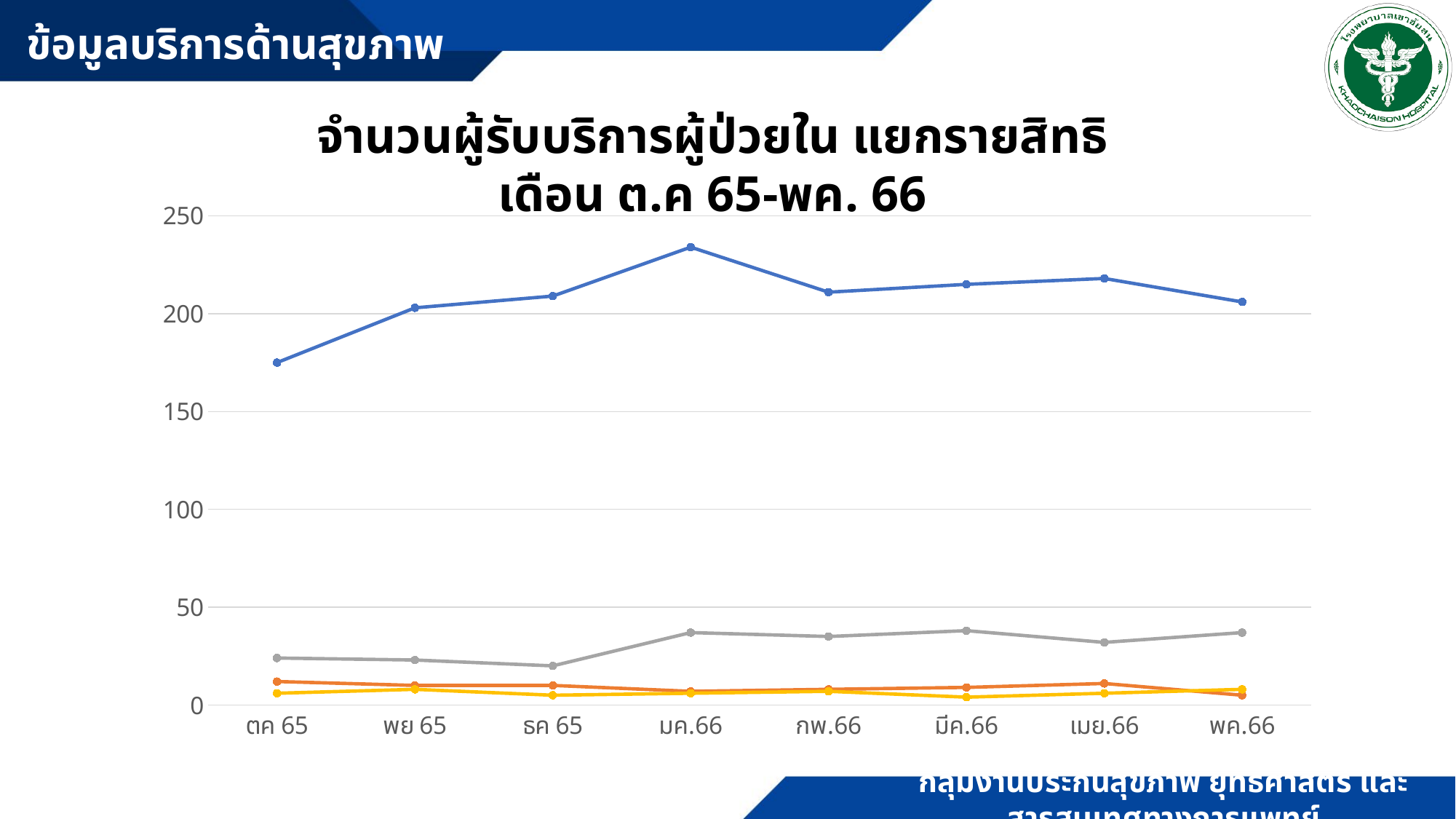
Is the value of the blue line for มค.66 greater or less than 200? greater How many months are shown on the x axis of the chart? 8 In which month does the blue line reach its highest value? มค.66 Is the value of the gray line for มค.66 greater or less than 50? less In which month does the blue line have its lowest value? ตค 65 Which line has the higher value in กพ.66, the blue line or the gray line? the blue line Is the value of the blue line for ตค 65 greater or less than 200? less What kind of chart is shown on the slide? line chart How many lines are plotted on the chart? 4 Does the blue line rise or fall from ตค 65 to มค.66? rise What is the first line of the chart title? จำนวนผู้รับบริการผู้ป่วยใน แยกรายสิทธิ